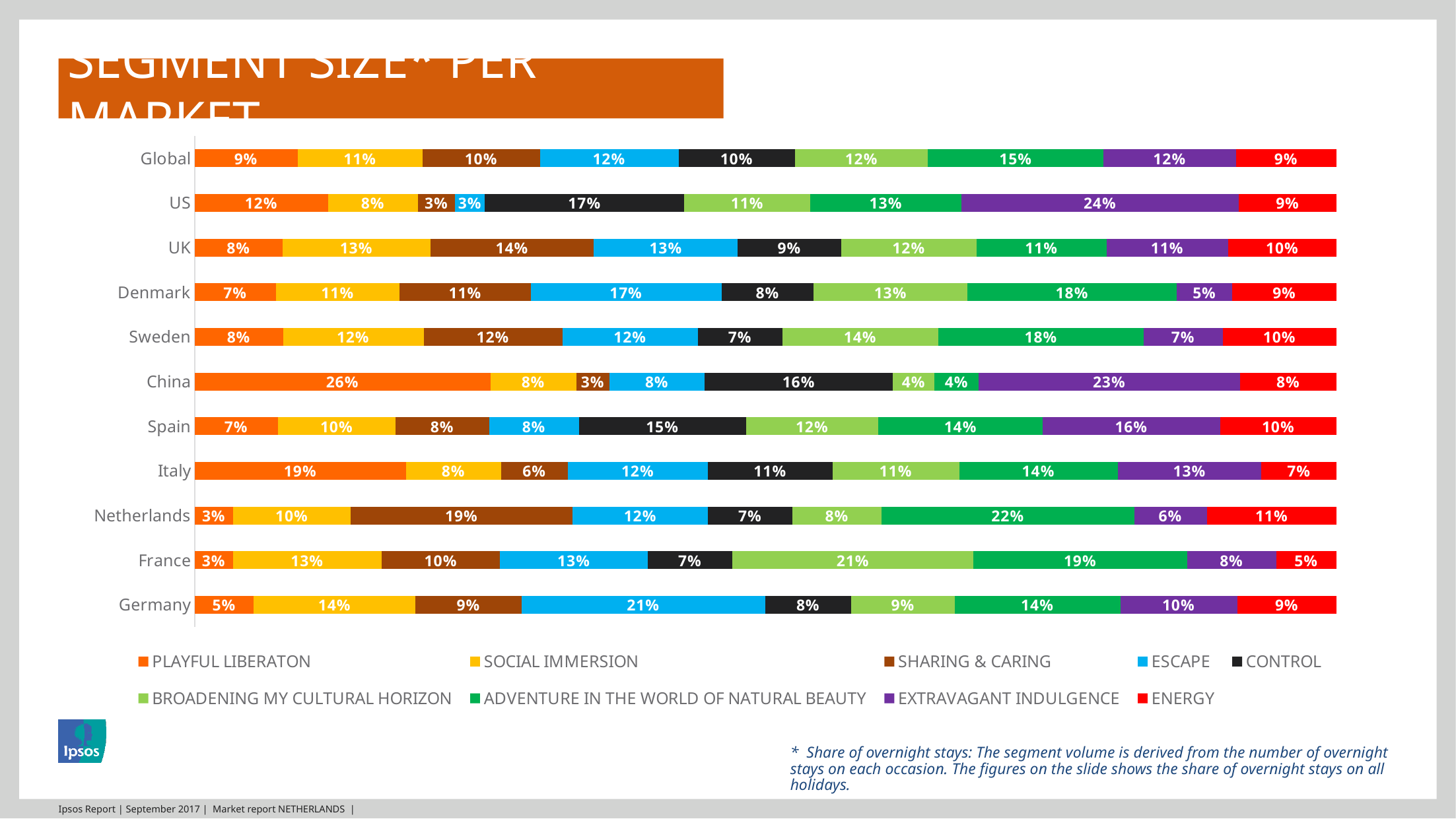
What is the value for Escape in Germany? 21% What is the difference between the Control values for the US and Global? 7% What is the value for Playful Liberaton in China? 26% What is the value for Adventure in the World of Natural Beauty in the Netherlands? 22% What is the value for Extravagant Indulgence in the US? 24% Which market has the lowest value for Energy? France Which is larger: Broadening My Cultural Horizon in France or in Spain? France Which colour represents the Energy segment in the chart? Red What kind of chart is shown on the slide? Stacked bar chart How many markets are shown on the chart? 11 Which market has the highest value for Playful Liberaton? China How many series does the legend list? 9